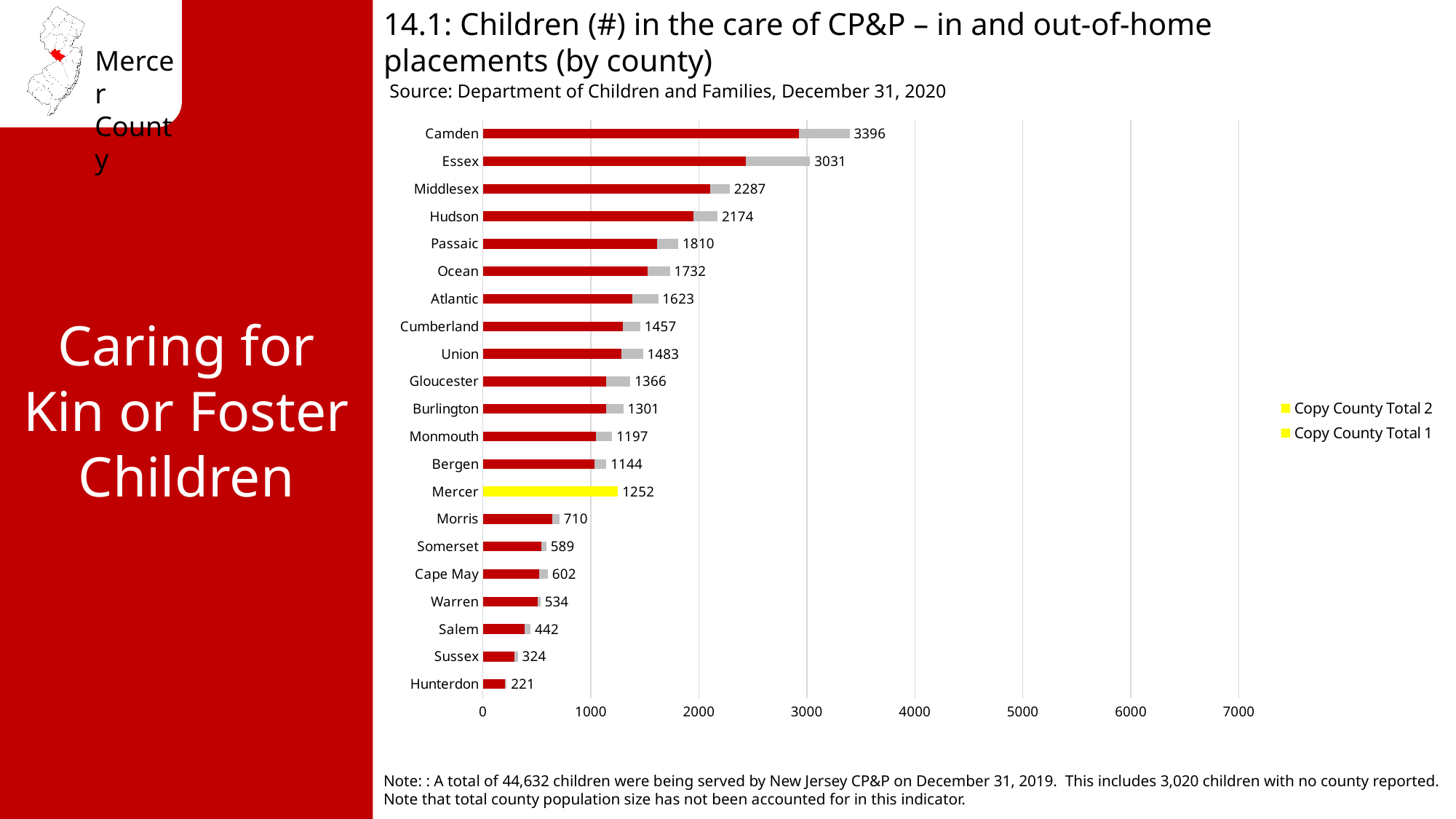
What is the difference between the values for Camden and Essex? 365 What is the total number of children in the care of CP&P for Camden? 3396 What is the difference between the values for Mercer and Bergen? 108 What type of chart is shown on the slide? Bar chart Which county has a larger value, Ocean or Atlantic? Ocean Which county has the lowest number of children in the care of CP&P? Hunterdon Is the value for Morris greater or less than 1000? less What is the value shown for Mercer? 1252 How many counties are shown in the chart? 21 Which county has the highest number of children in the care of CP&P? Camden What is the value shown for Hunterdon? 221 How many series does the legend list? 2